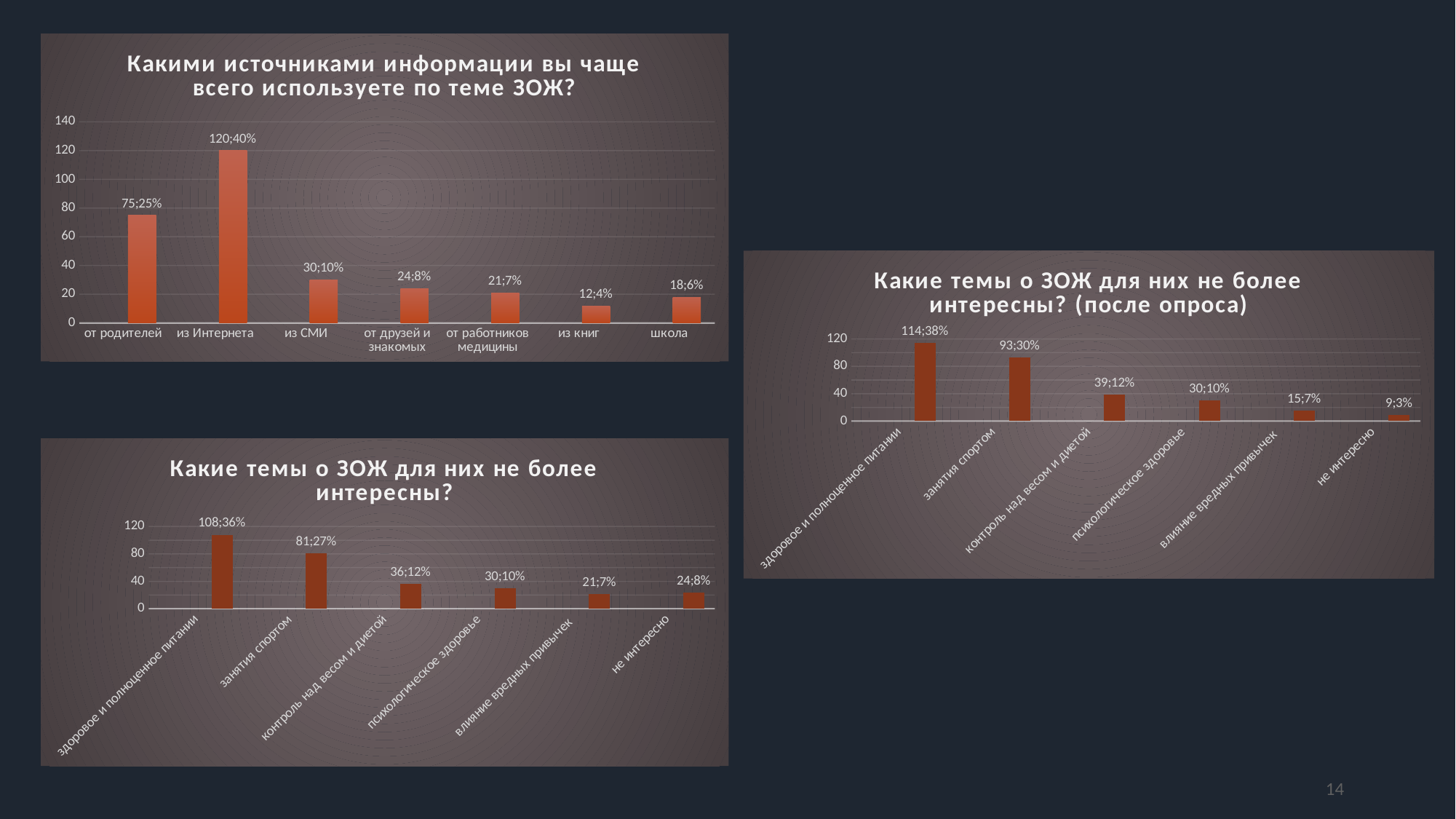
In the top-left chart about sources of information, how many categories are shown on the x axis? 7 In the right chart '(после опроса)', how many categories are shown on the x axis? 6 In the bottom-left chart 'Какие темы о ЗОЖ для них не более интересны?', is the value for 'контроль над весом и диетой' greater or less than 40? less What type of chart is the top-left chart about sources of information? bar chart In the bottom-left chart 'Какие темы о ЗОЖ для них не более интересны?', which category has the highest value? здоровое и полноценное питании In the bottom-left chart 'Какие темы о ЗОЖ для них не более интересны?', what is the data label for 'занятия спортом'? 81;27% In the top-left chart about sources of information, which category has the lowest value? из книг In the right chart '(после опроса)', what is the difference between the counts for 'здоровое и полноценное питании' (114) and 'занятия спортом' (93)? 21 In the top-left chart about sources of information, which is larger: the value for 'из СМИ' or the value for 'школа'? из СМИ In the right chart 'Какие темы о ЗОЖ для них не более интересны? (после опроса)', what is the data label for 'не интересно'? 9;3% In the top-left chart about sources of information, what is the difference between the counts for 'из Интернета' (120) and 'от родителей' (75)? 45 In the top-left chart 'Какими источниками информации вы чаще всего используете по теме ЗОЖ?', what is the data label for 'из Интернета'? 120;40%